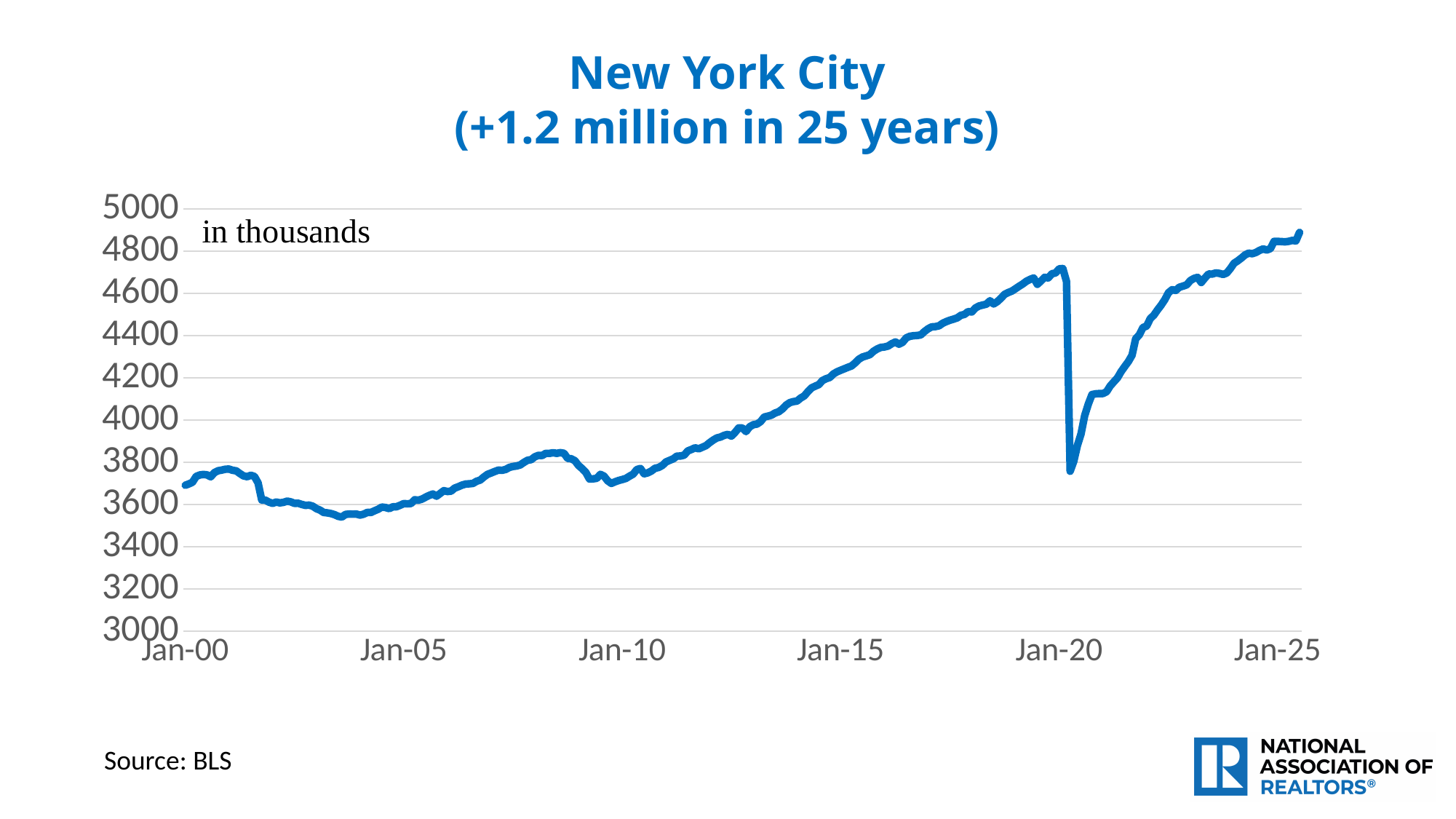
Is the value at Jan-20 greater or less than 4600? greater How many date labels are shown on the x axis? 6 Is the value at Jan-00 greater or less than 3800? less Is the value at Jan-25 greater or less than 4800? greater Around which labelled x-axis date does the line show its sharpest drop? Jan-20 In what units are the values on the chart expressed? in thousands Which is larger, the value at Jan-00 or the value at Jan-25? Jan-25 What kind of chart is shown on the slide? line chart What is the title of the chart? New York City (+1.2 million in 25 years) Overall, do the values rise or fall from Jan-00 to Jan-25? rise